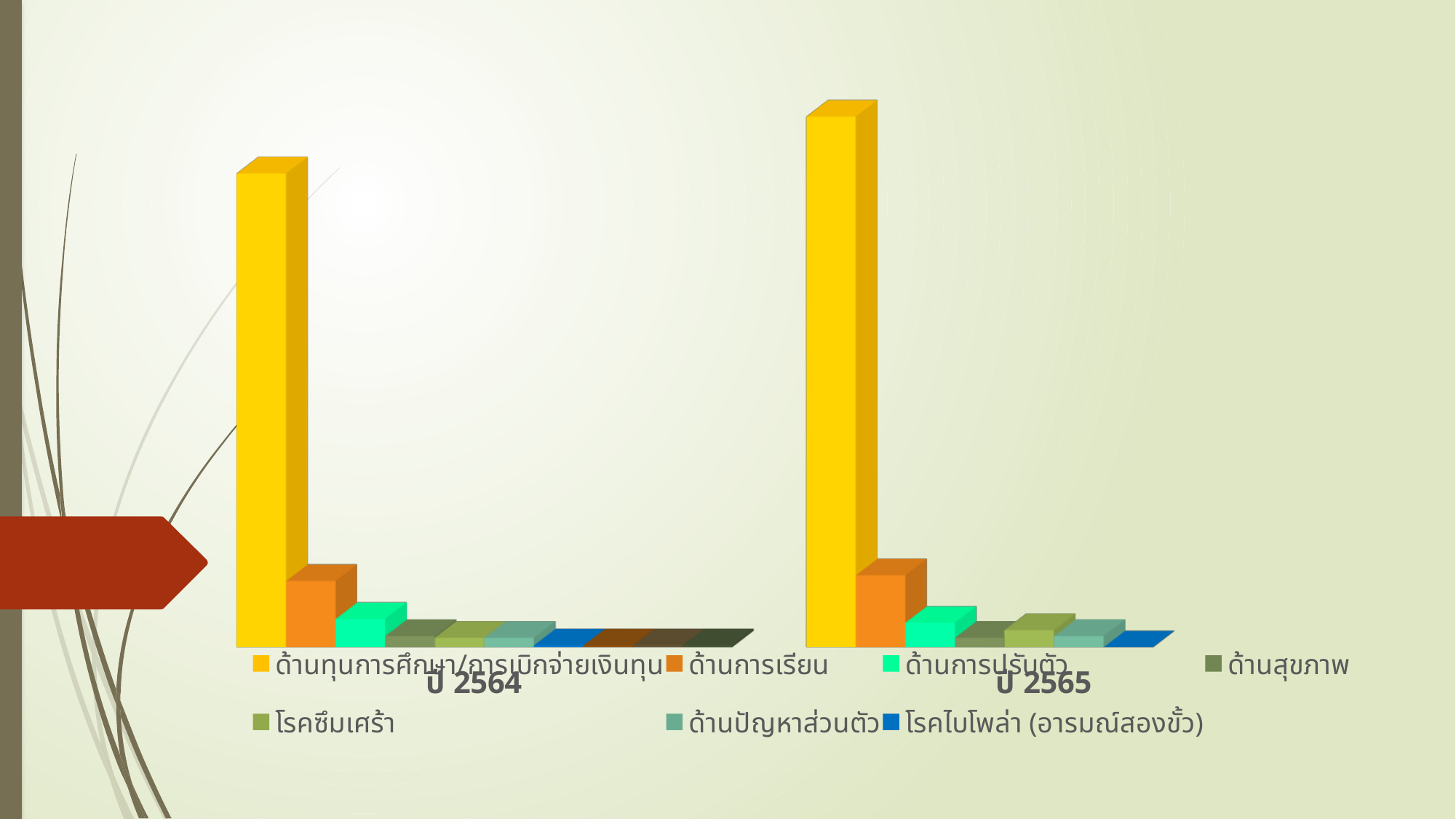
Which series has the second-tallest bar in the ปี 2565 group? ด้านการเรียน What colour represents the series ด้านการเรียน in the legend? Orange How many series does the chart's legend list? 7 Which series has the highest bar in the ปี 2564 group? ด้านทุนการศึกษา/การเบิกจ่ายเงินทุน In the ปี 2565 group, which bar is taller: โรคซึมเศร้า or ด้านสุขภาพ? โรคซึมเศร้า Which series has the highest bar in the ปี 2565 group? ด้านทุนการศึกษา/การเบิกจ่ายเงินทุน Which series is shown in blue in the legend? โรคไบโพล่า (อารมณ์สองขั้ว) What kind of chart is shown on the slide? Bar chart Does the value for ด้านทุนการศึกษา/การเบิกจ่ายเงินทุน rise or fall from ปี 2564 to ปี 2565? Rise For the series ด้านทุนการศึกษา/การเบิกจ่ายเงินทุน, is the bar for ปี 2564 or ปี 2565 taller? ปี 2565 In the ปี 2564 group, which bar is taller: ด้านการเรียน or ด้านการปรับตัว? ด้านการเรียน How many categories are shown on the x axis of the chart? 2